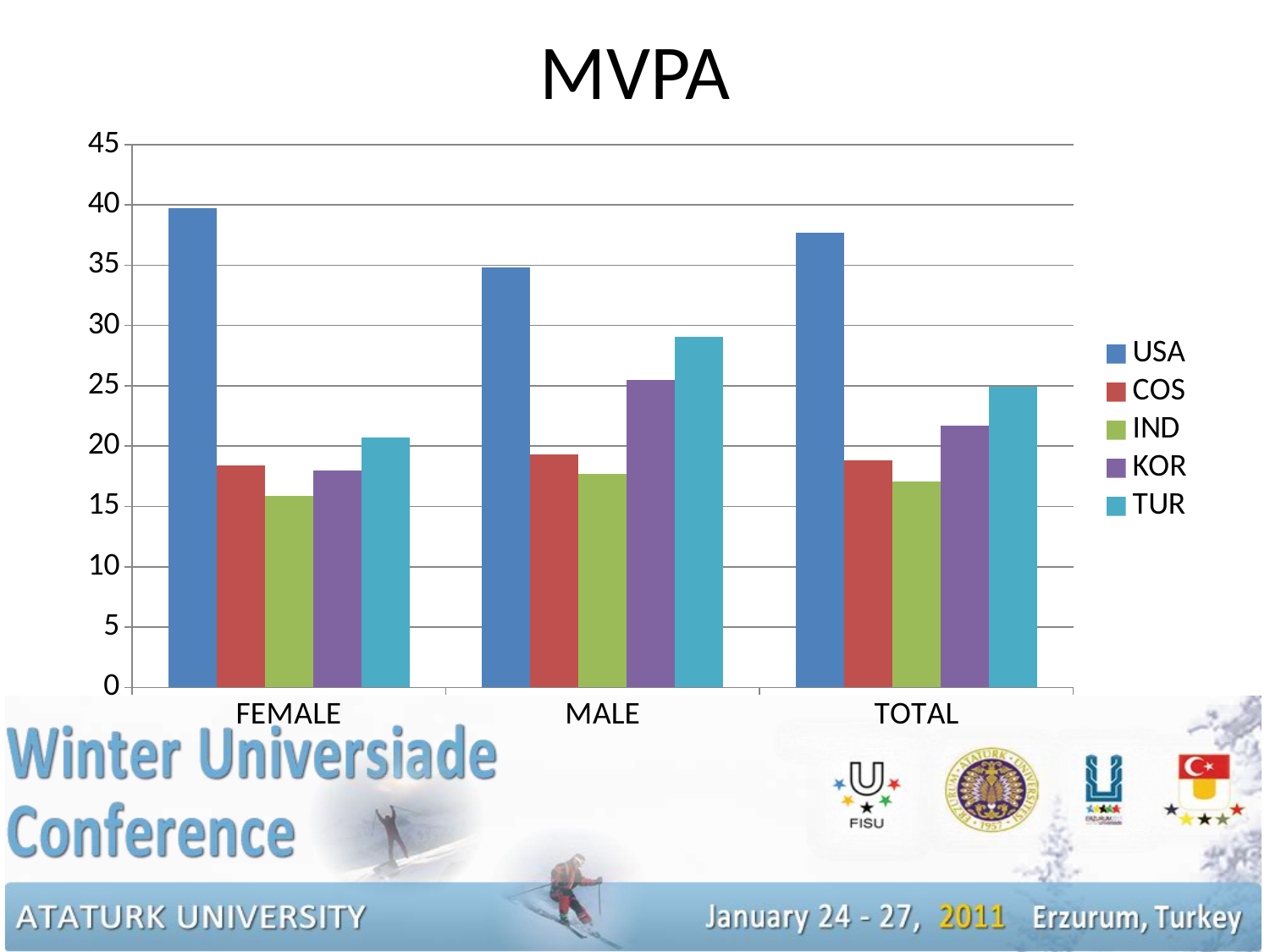
Is the value for USA in the FEMALE category greater or less than 35? greater What is the title of the chart? MVPA Is the value for KOR in the TOTAL category greater or less than 20? greater What kind of chart is shown on the slide? bar chart How many series does the legend list? 5 Is the value for TUR in the MALE category greater or less than 30? less Which series has the lowest value in the MALE category? IND Which series is shown in purple in the legend? KOR Which series has the highest value in the FEMALE category? USA How many categories are shown on the x axis? 3 Which series has the lowest value in the TOTAL category? IND In the MALE category, which is larger, the value for KOR or the value for TUR? TUR